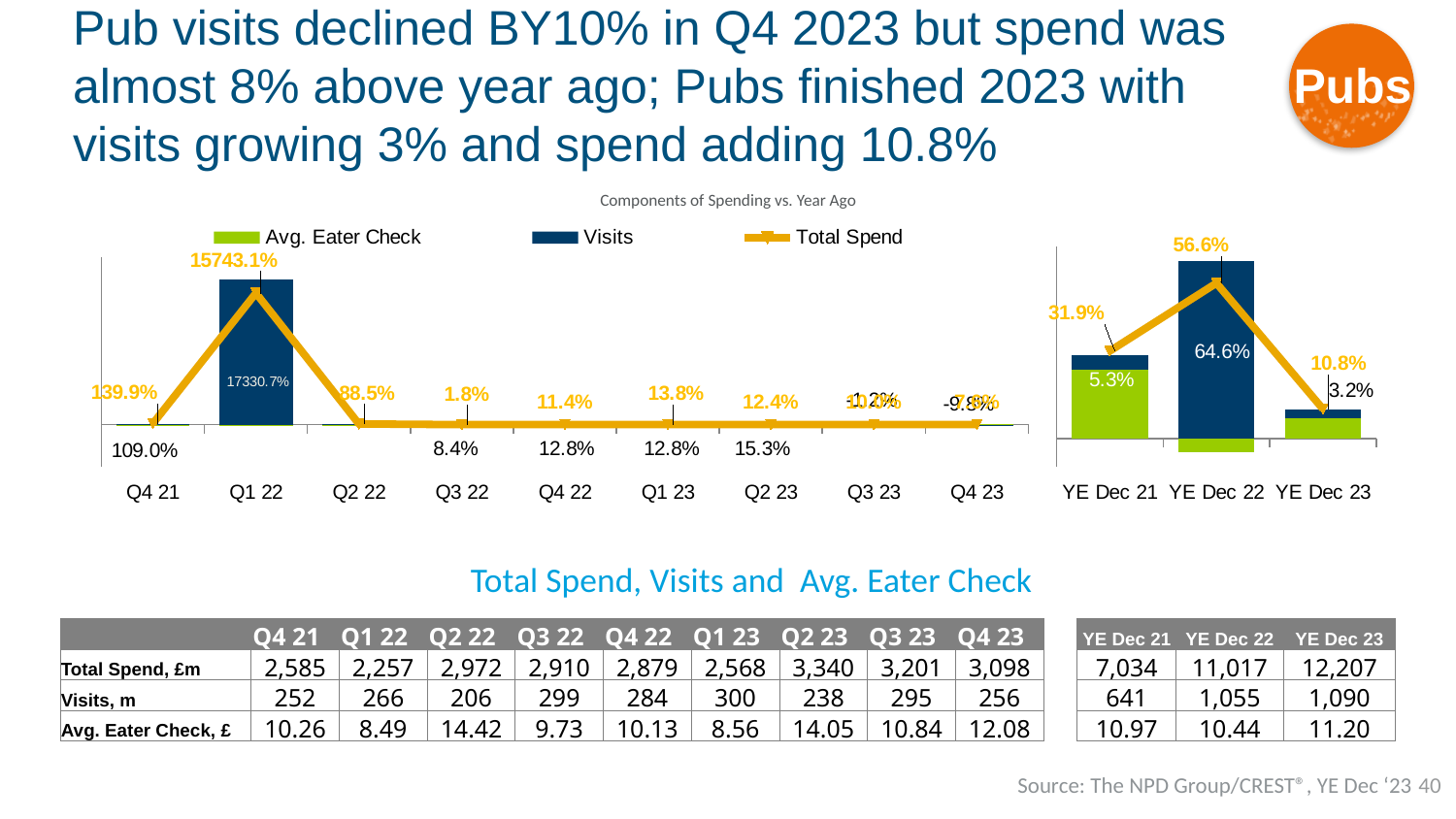
In the right-hand chart (YE Dec 21 to YE Dec 23), what is the Total Spend value for YE Dec 22? 56.6% In the left-hand quarterly chart 'Components of Spending vs. Year Ago', what is the Total Spend value for Q3 22? 1.8% In the right-hand chart (YE Dec 21 to YE Dec 23), which year has the highest Total Spend value? YE Dec 22 In the left-hand quarterly chart 'Components of Spending vs. Year Ago', which has the larger Total Spend value, Q1 23 or Q2 23? Q1 23 How many series does the legend of the 'Components of Spending vs. Year Ago' chart list? 3 In the right-hand chart (YE Dec 21 to YE Dec 23), what is the Visits value for YE Dec 22? 64.6% In the right-hand chart (YE Dec 21 to YE Dec 23), how much higher is the Total Spend value for YE Dec 22 than for YE Dec 23? 45.8 percentage points How many quarters are shown on the x axis of the left-hand chart 'Components of Spending vs. Year Ago'? 9 In the left-hand quarterly chart 'Components of Spending vs. Year Ago', what is the Total Spend value for Q4 22? 11.4% In the right-hand chart (YE Dec 21 to YE Dec 23), what is the Total Spend value for YE Dec 23? 10.8%